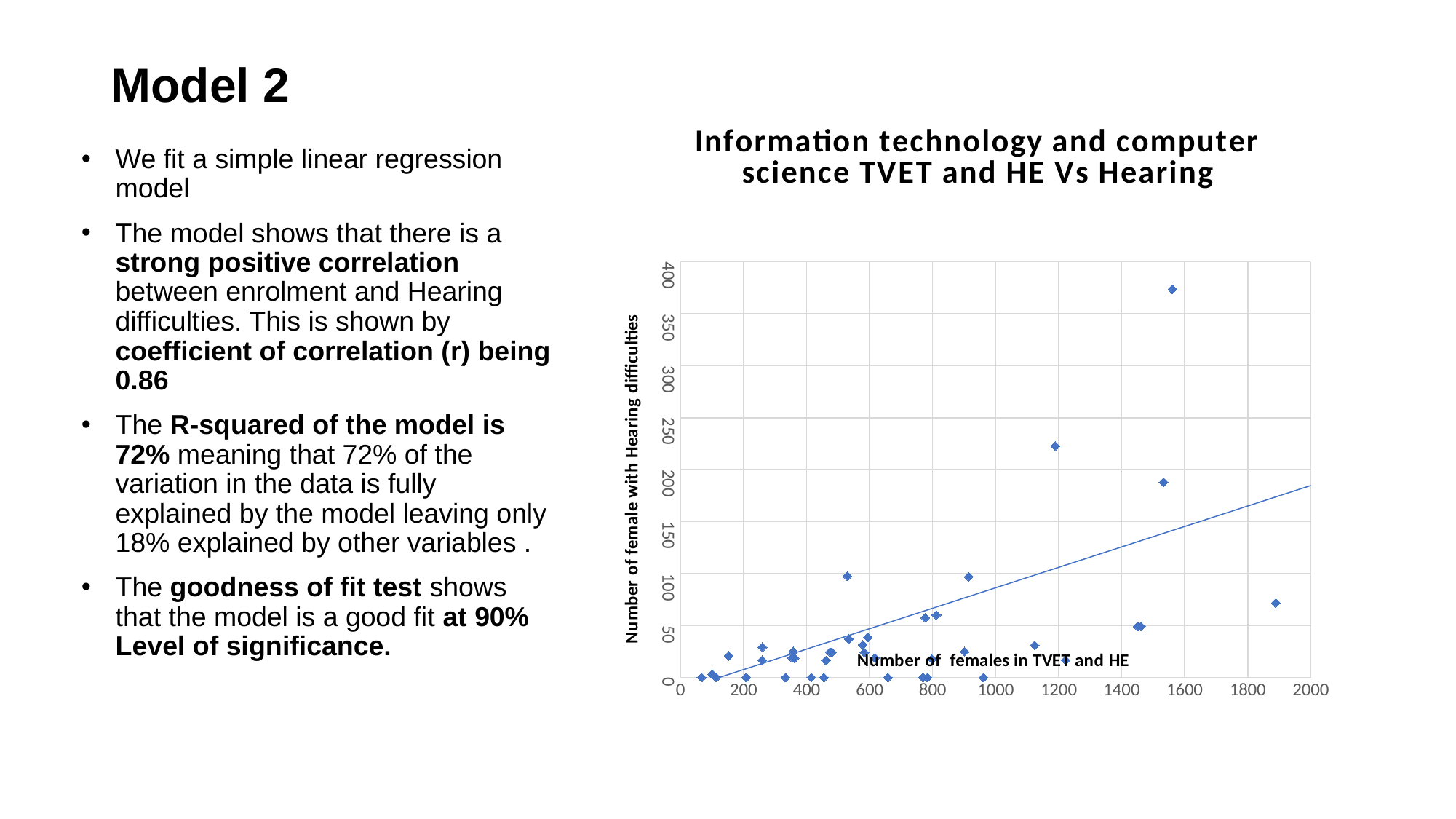
What is the label of the vertical axis of the chart? Number of female with Hearing difficulties Which is higher on the y axis: the point near 1200 on the x axis or the point near 1900 on the x axis? The point near 1200 What is the highest value shown on the x axis of the chart? 2000 What is the highest value shown on the y axis of the chart? 400 Is the value for the point furthest to the right on the x axis (near 1900) greater or less than 100 on the y axis? less What kind of chart is shown on the slide? Scatter chart Is the highest point on the chart greater or less than 350 on the y axis? greater Is the value for the point near 1200 on the x axis greater or less than 200 on the y axis? greater Do the plotted values generally rise or fall as the number of females in TVET and HE increases along the x axis? Rise What is the title of the chart? Information technology and computer science TVET and HE Vs Hearing